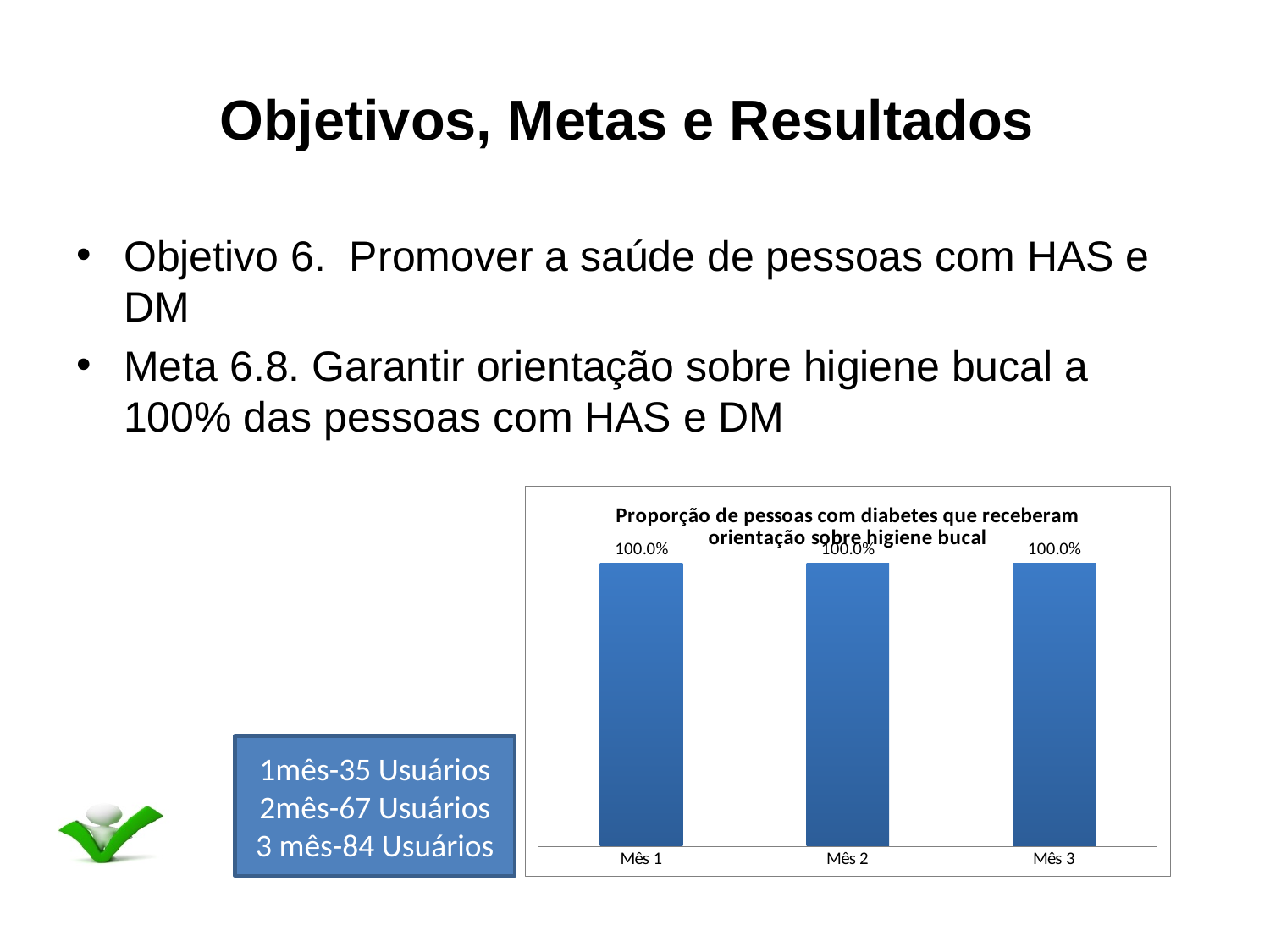
Is the value for Mês 2 larger than, smaller than, or equal to the value for Mês 1? Equal How many categories are shown on the x axis of the chart? 3 What kind of chart is shown on the slide? Bar chart What is the value for Mês 1 in the chart? 100.0% What is the difference between the values for Mês 1 and Mês 3? 0.0% What is the label of the first category on the x axis of the chart? Mês 1 What is the value for Mês 3 in the chart? 100.0% What is the value for Mês 2 in the chart? 100.0% Do the values rise, fall or stay the same from Mês 1 to Mês 3? Stay the same What is the title of the chart? Proporção de pessoas com diabetes que receberam orientação sobre higiene bucal